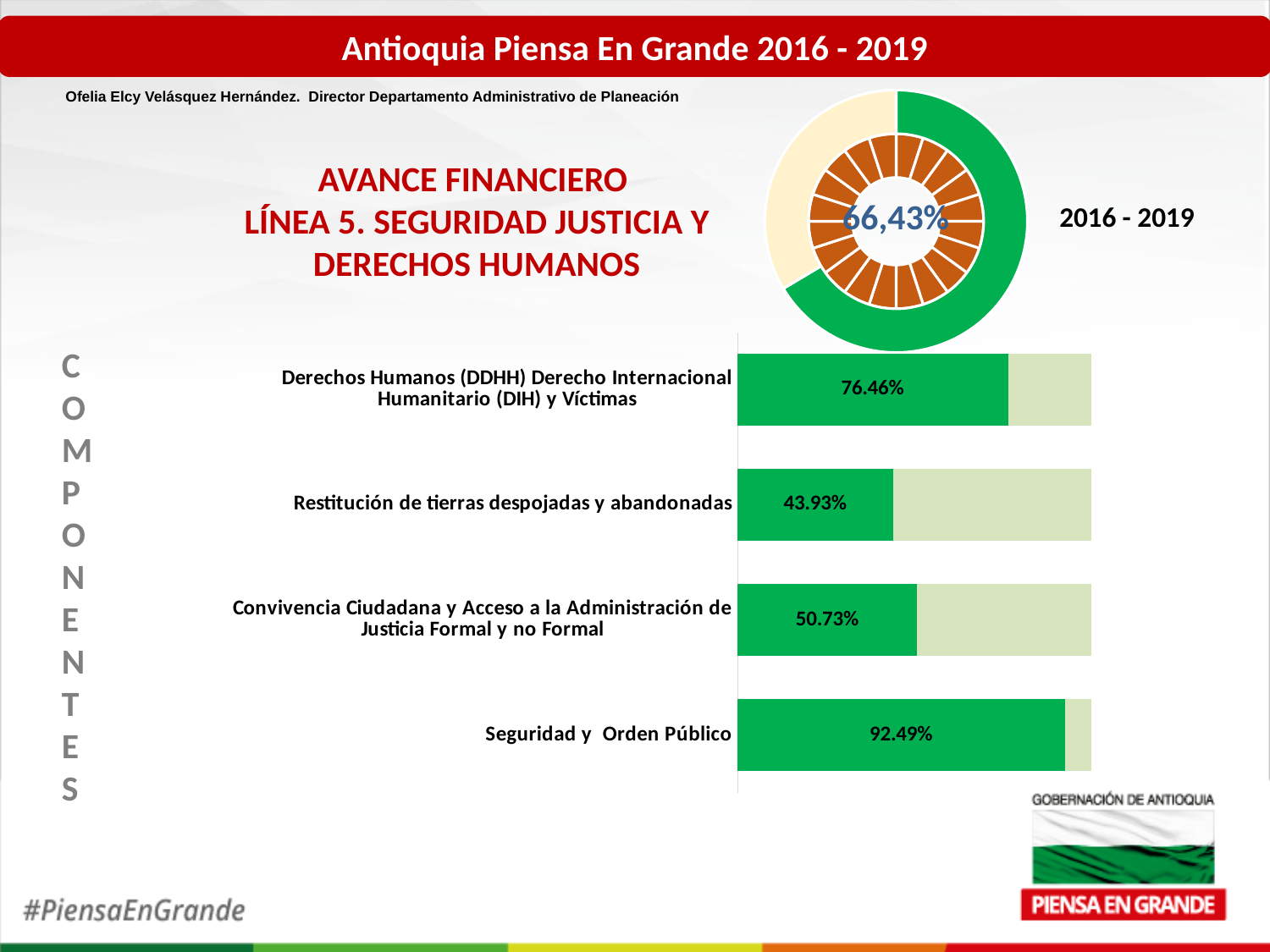
In the bar chart, what is the difference between the values for Seguridad y Orden Público and Restitución de tierras despojadas y abandonadas? 48.56% In the bar chart, which component has the lowest value? Restitución de tierras despojadas y abandonadas In the donut chart at the top right, what percentage is shown for 2016 - 2019? 66,43% What kind of chart is used to show the components? Bar chart In the bar chart, what is the value for Restitución de tierras despojadas y abandonadas? 43.93% In the bar chart, what is the value for Convivencia Ciudadana y Acceso a la Administración de Justicia Formal y no Formal? 50.73% How many components are shown in the bar chart? 4 What kind of chart shows the 66,43% value at the top right of the slide? Donut chart In the bar chart, which is larger: the value for Derechos Humanos (DDHH) Derecho Internacional Humanitario (DIH) y Víctimas or the value for Convivencia Ciudadana y Acceso a la Administración de Justicia Formal y no Formal? Derechos Humanos (DDHH) Derecho Internacional Humanitario (DIH) y Víctimas In the bar chart, what is the value for Derechos Humanos (DDHH) Derecho Internacional Humanitario (DIH) y Víctimas? 76.46% In the bar chart, what is the value for Seguridad y Orden Público? 92.49% In the bar chart, which component has the highest value? Seguridad y Orden Público